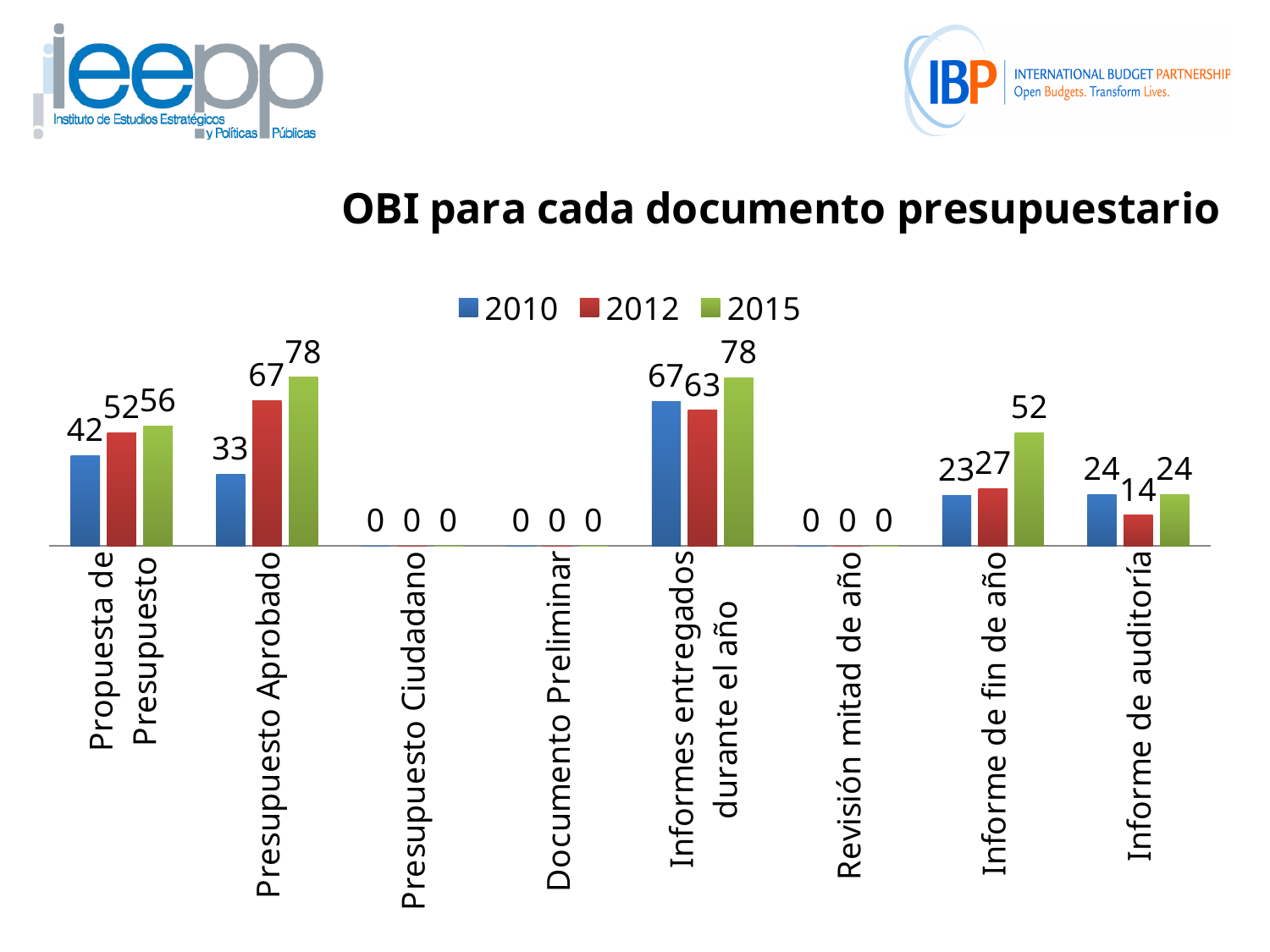
How many categories are shown on the x axis? 8 Which colour represents the 2015 series in the legend? Green What kind of chart is shown on the slide? Bar chart How many series does the legend list? 3 What is the title of the chart? OBI para cada documento presupuestario Which is larger for Informes entregados durante el año: the 2010 value or the 2012 value? 2010 What is the difference between the 2015 and 2010 values for Presupuesto Aprobado? 45 What is the 2012 value for Informe de auditoría? 14 Do the values for Informe de fin de año rise or fall from 2010 to 2015? Rise Which category has the lowest 2015 value among those with non-zero values? Informe de auditoría What is the 2010 value for Propuesta de Presupuesto? 42 What is the 2015 value for Presupuesto Aprobado? 78